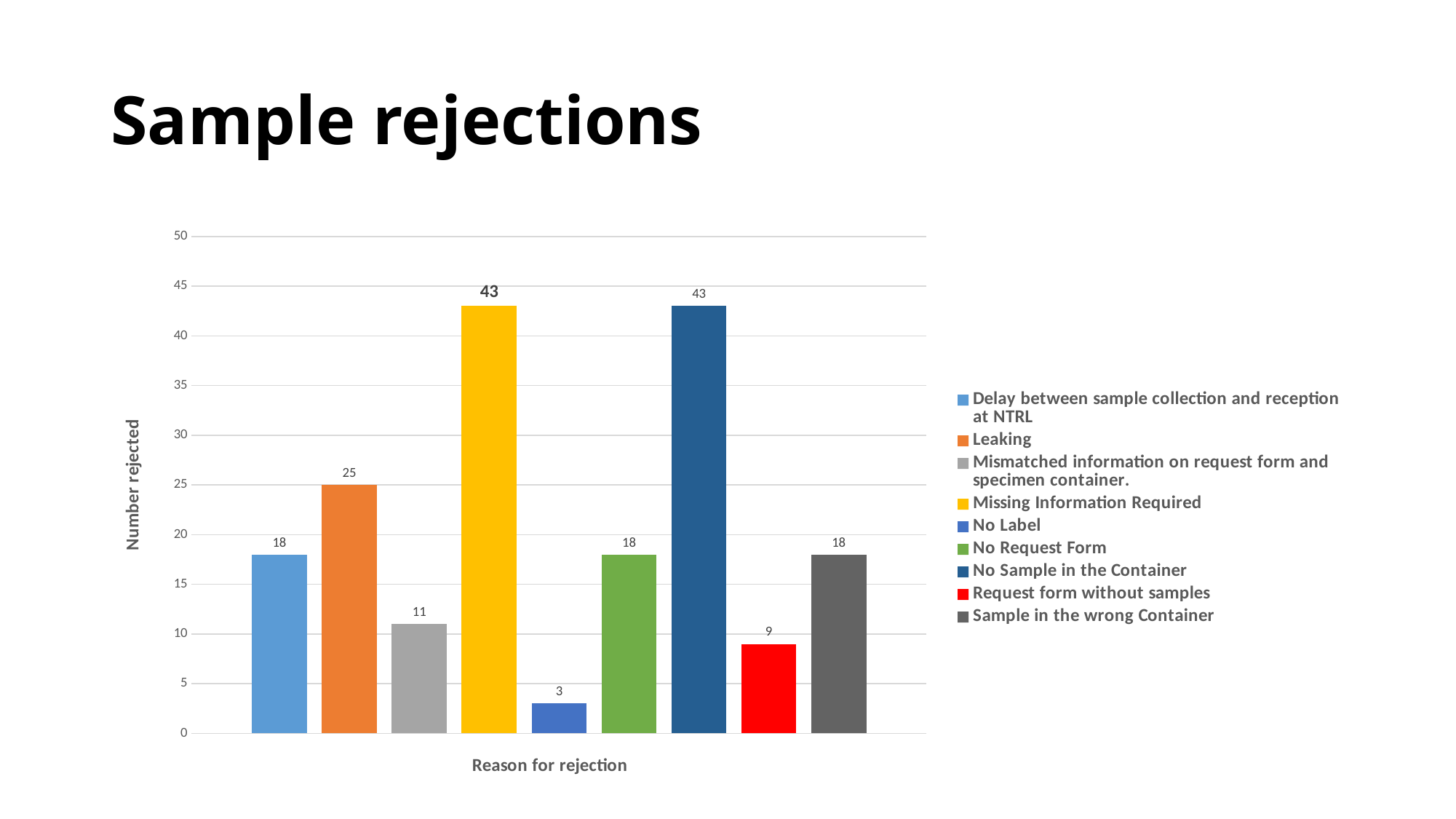
How many entries does the legend list? 9 What is the number rejected for Leaking? 25 What is the difference between the number rejected for Missing Information Required and for Request form without samples? 34 What is the number rejected for Request form without samples? 9 Which reason for rejection has the lowest number rejected? No Label What is the number rejected for Mismatched information on request form and specimen container? 11 Which has a larger number rejected, Leaking or Sample in the wrong Container? Leaking How many reasons for rejection are plotted in the chart? 9 Is the number rejected for No Sample in the Container greater or less than 40? greater What kind of chart is shown on the slide? bar chart What is the difference between the number rejected for Leaking and for No Label? 22 What is the number rejected for No Label? 3